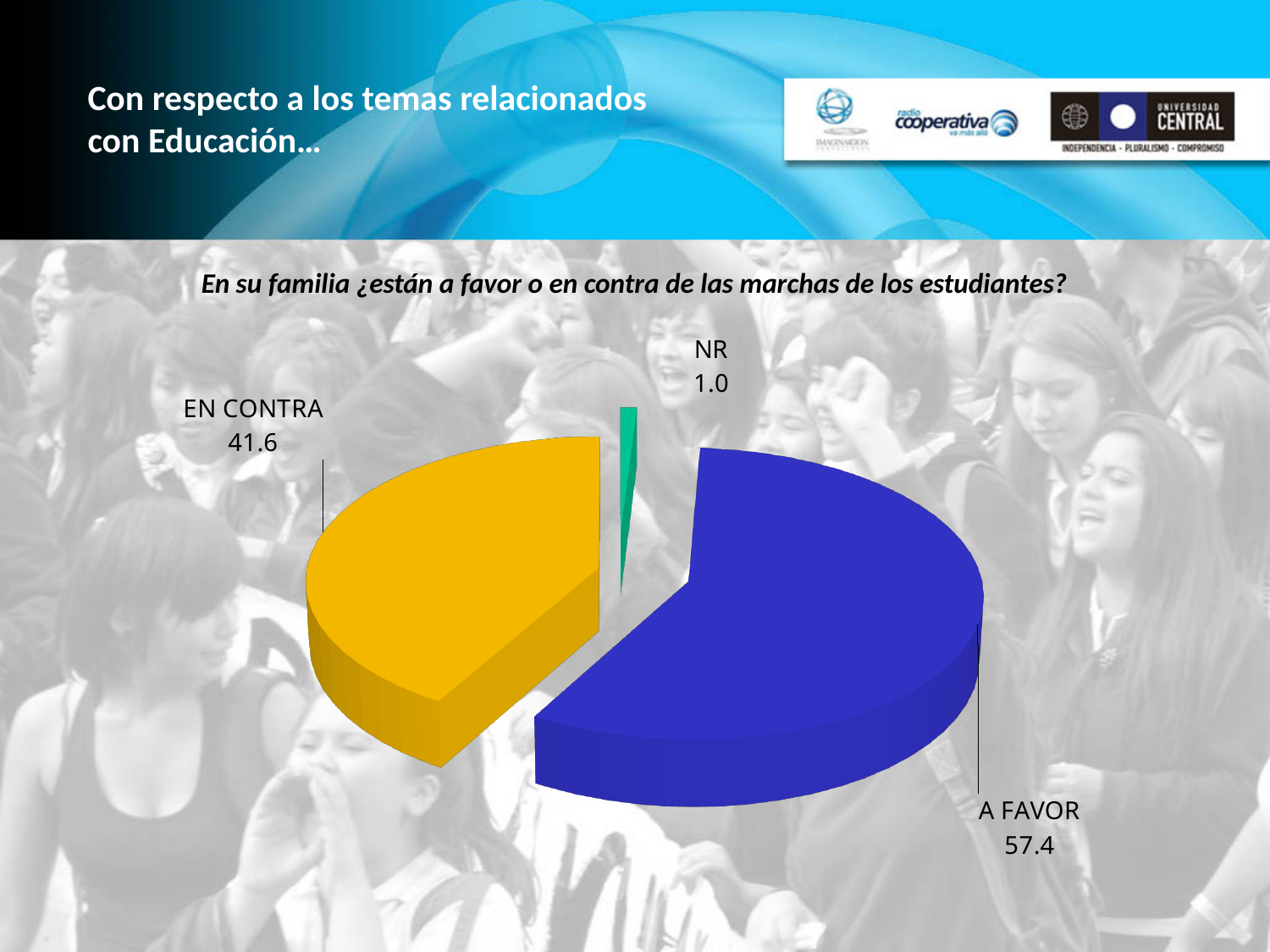
What is the value for A FAVOR? 57.4 What is the value for NR? 1.0 What is the difference between the values for A FAVOR and EN CONTRA? 15.8 How many categories does the pie chart show? 3 What kind of chart is shown on the slide? Pie chart What is the difference between the values for EN CONTRA and NR? 40.6 Which is larger, A FAVOR or EN CONTRA? A FAVOR Which category has the largest slice? A FAVOR What colour is the A FAVOR slice? Blue What question does the chart title ask? En su familia ¿están a favor o en contra de las marchas de los estudiantes? Which category has the smallest slice? NR What is the value for EN CONTRA? 41.6